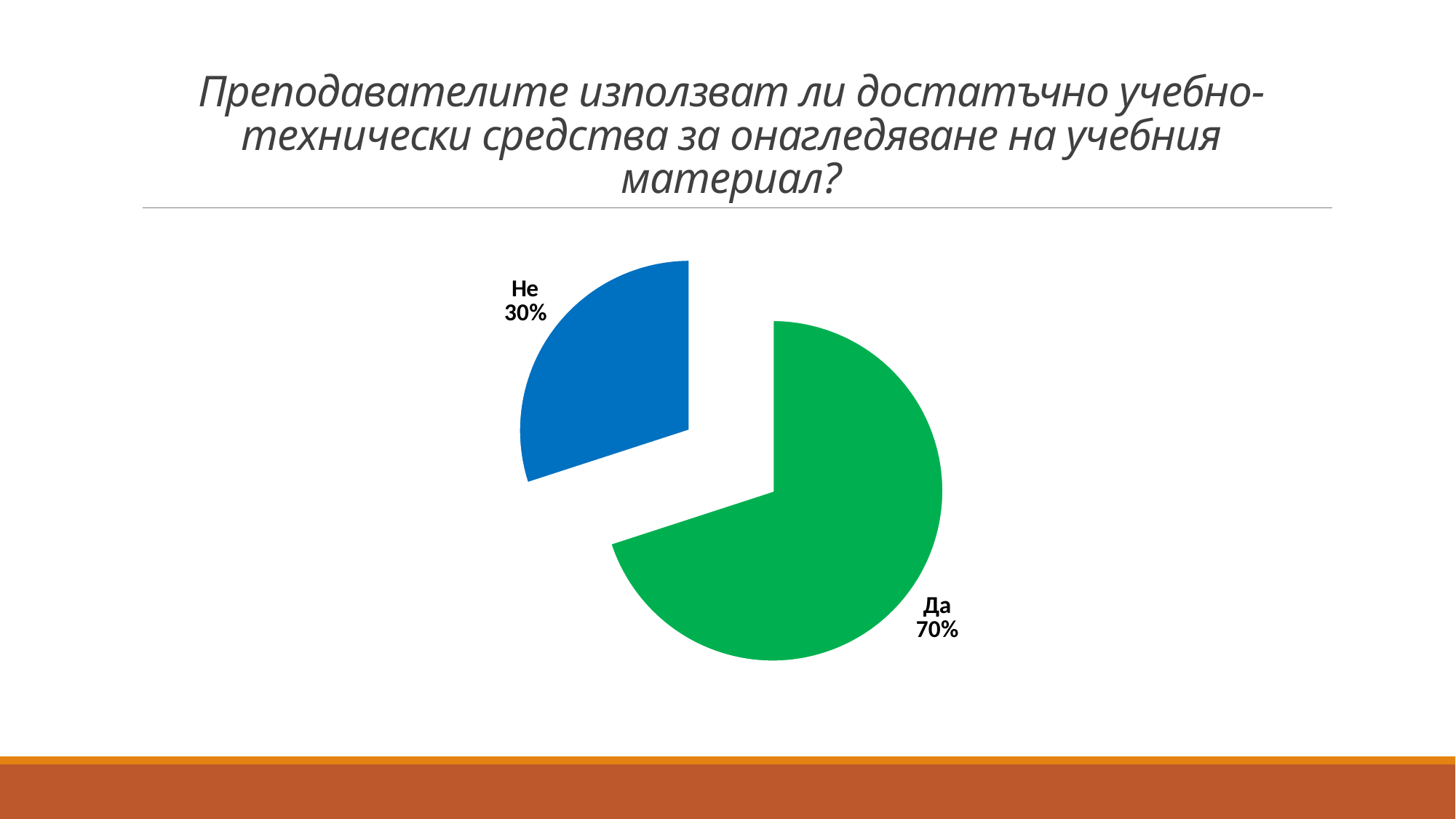
What colour is the "Да" slice? green What share of the pie does "Да" represent? 70% Which slice of the pie is the largest? Да What is the difference in percentage points between the "Да" and "Не" slices? 40% What kind of chart is shown on the slide? pie chart What colour is the "Не" slice? blue What is the total of the two slices shown in the pie chart? 100% Which is larger, the "Да" slice or the "Не" slice? Да How many slices does the pie chart have? 2 Which slice of the pie is the smallest? Не What share of the pie does "Не" represent? 30%